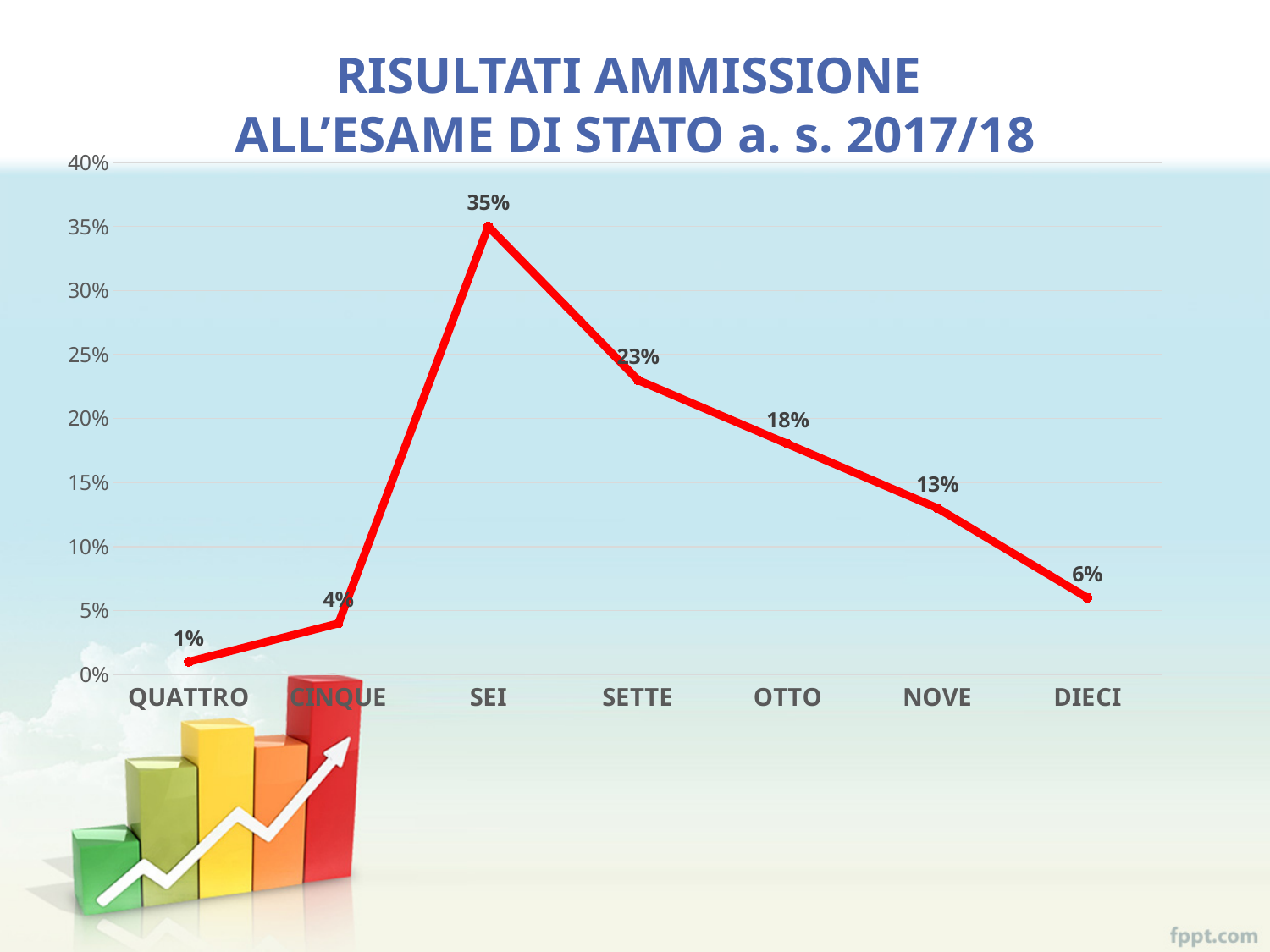
What is the value for OTTO? 18% What is the difference between the values for SEI and SETTE? 12% How many categories are shown on the x axis? 7 What is the value for SEI? 35% Which is larger, the value for CINQUE or the value for NOVE? NOVE Do the values rise or fall from SEI to DIECI? fall What is the value for DIECI? 6% Is the value for SETTE greater or less than 20%? greater Which category has the highest value? SEI What kind of chart is shown on the slide? line chart Which category has the lowest value? QUATTRO What is the difference between the values for NOVE and DIECI? 7%